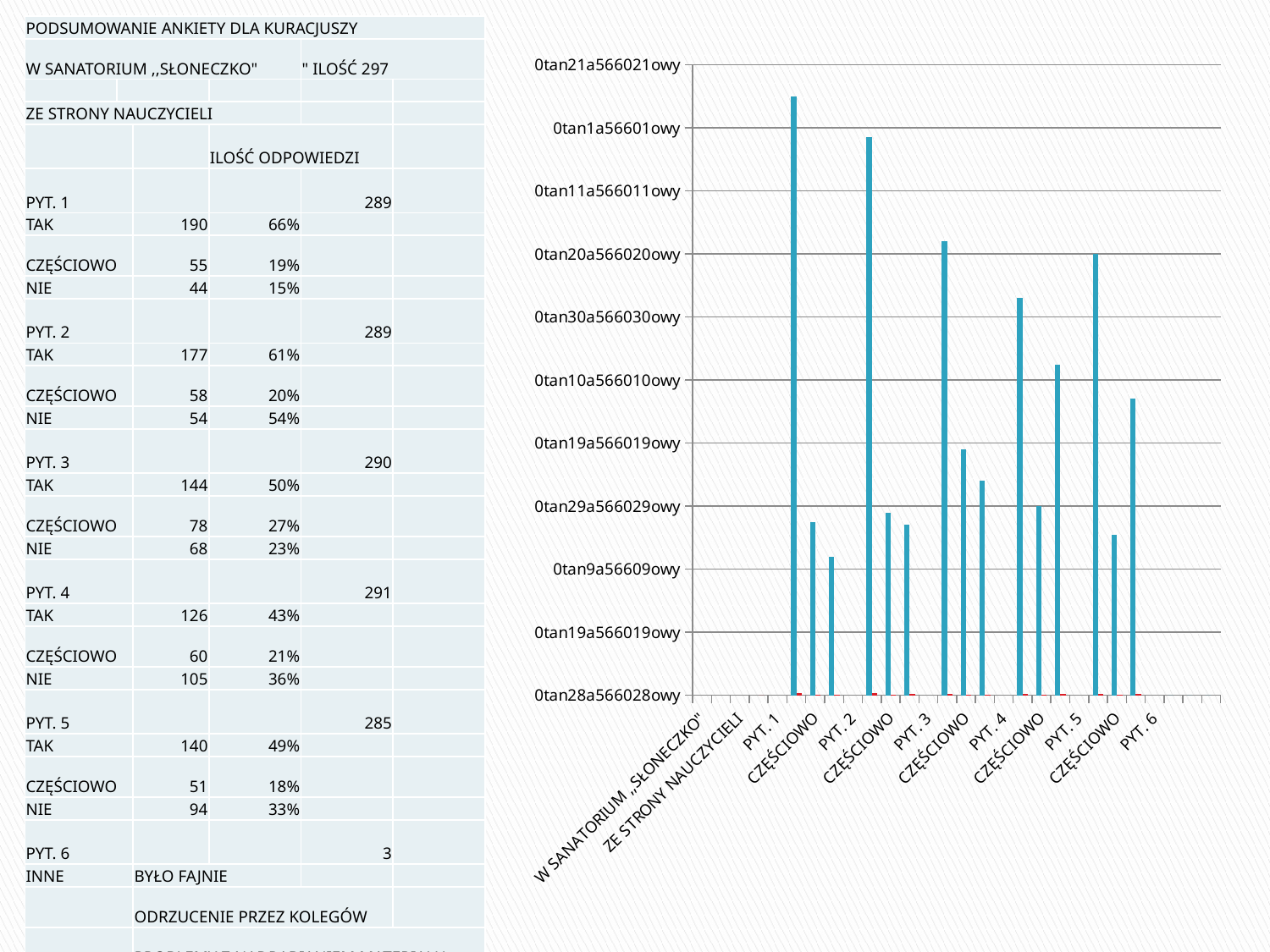
Do the bars at the PYT. 1, PYT. 2, PYT. 3 and PYT. 4 labels rise or fall from left to right? fall Does the chart display a legend? No What kind of chart is shown on the slide? bar chart Which x-axis label has the tallest bar in the chart? PYT. 1 How many blue bars are plotted in the chart? 15 Which bar is taller, the one at PYT. 3 or the one at PYT. 4? PYT. 3 Which bar is taller, the one at PYT. 4 or the one at PYT. 5? PYT. 5 Is the CZĘŚCIOWO bar following PYT. 3 taller or shorter than the CZĘŚCIOWO bar following PYT. 1? taller What colour are the bars in the chart? blue